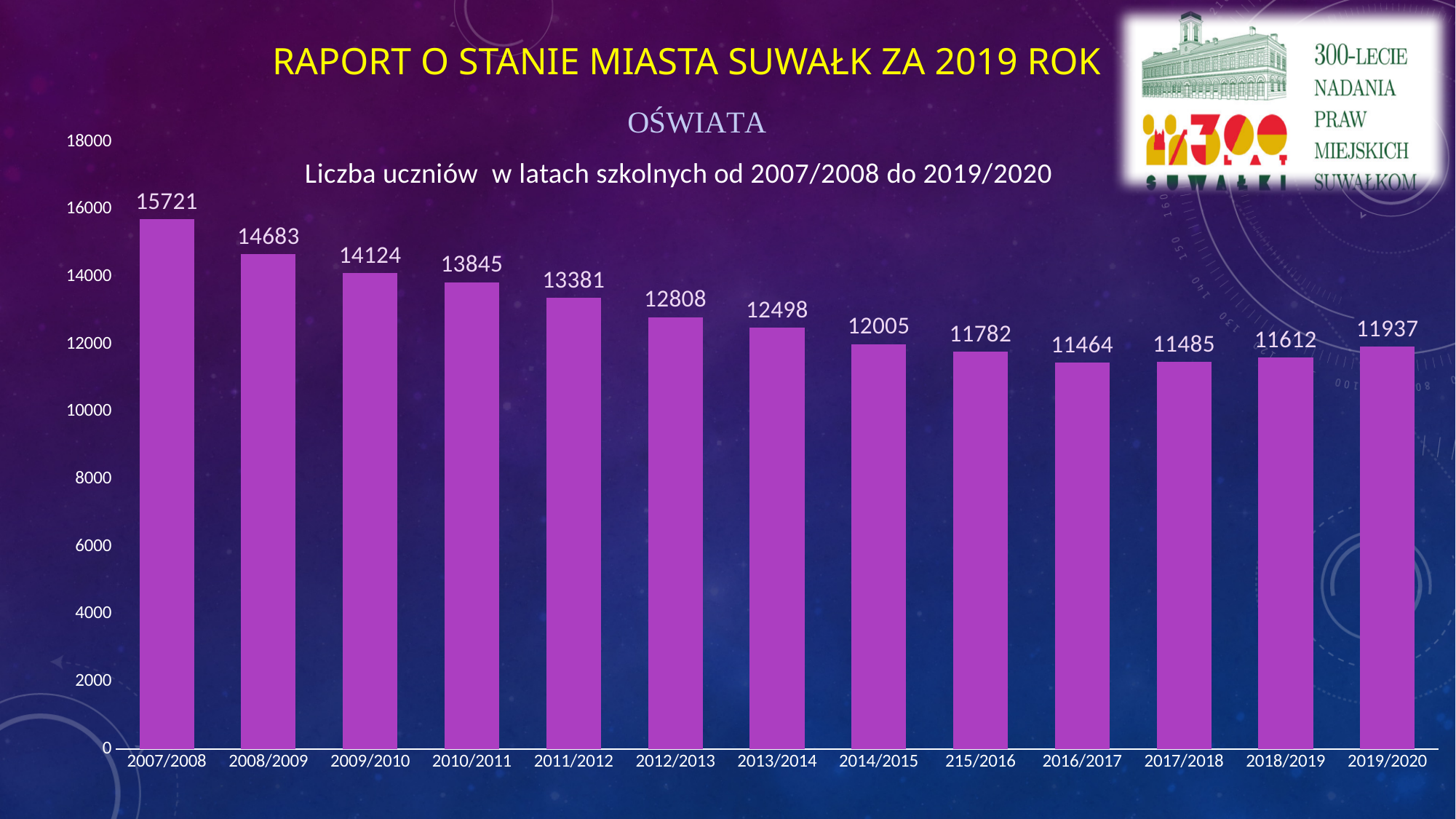
How many school years are shown on the chart? 13 What is the number of pupils shown for the 2007/2008 school year? 15721 What is the difference between the values for 2012/2013 and 2013/2014? 310 What kind of chart is shown on the slide? bar chart What value is shown for the 2019/2020 school year? 11937 What is the difference between the values for 2007/2008 and 2019/2020? 3784 What is the value for the 2012/2013 school year? 12808 Which school year has the lowest number of pupils? 2016/2017 Which school year has the highest number of pupils? 2007/2008 Do the values generally rise or fall from 2007/2008 to 2016/2017? fall Which is larger, the value for 2010/2011 or the value for 2014/2015? 2010/2011 Is the value for 2011/2012 greater or less than 14000? less